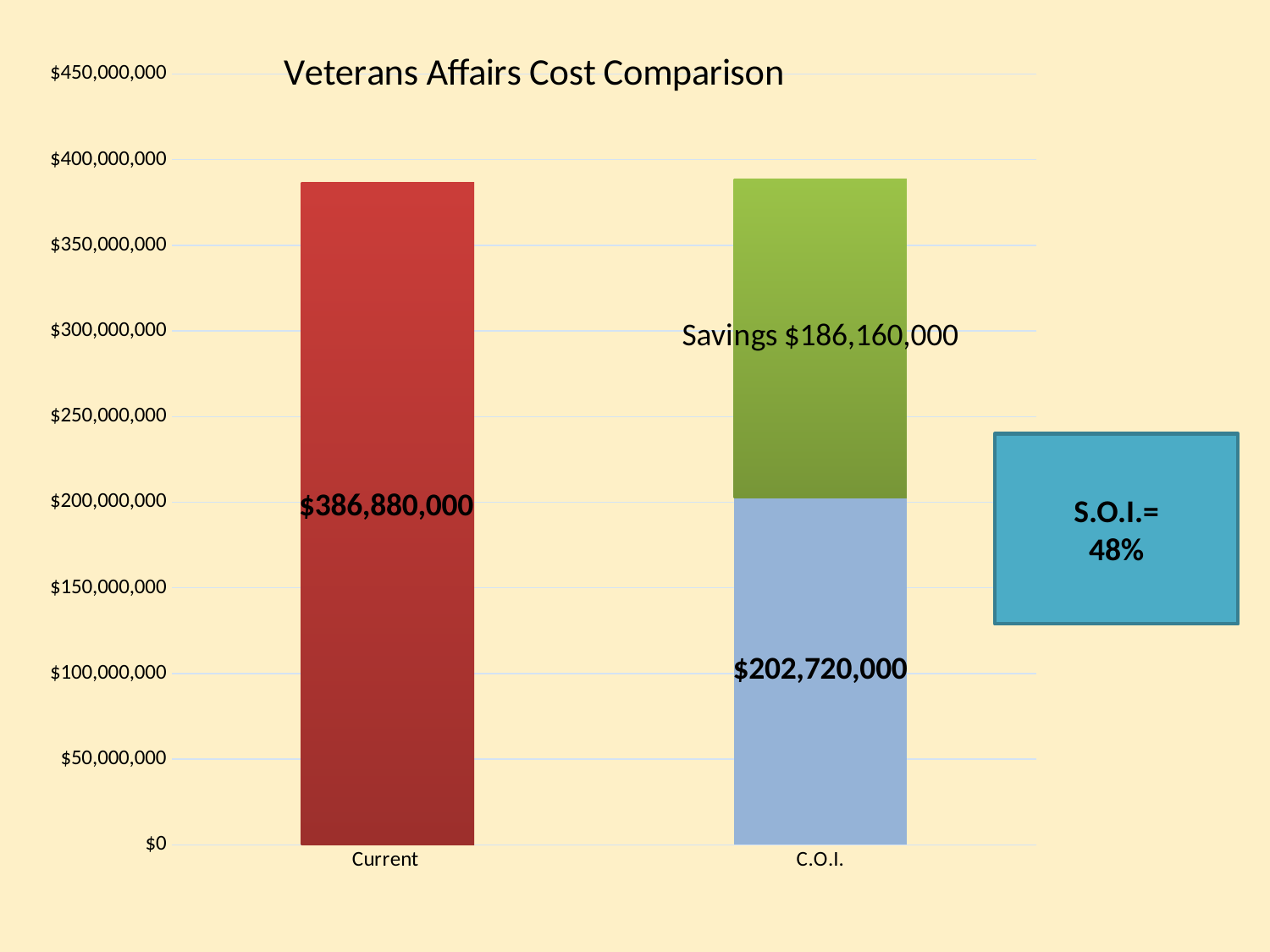
Is the value for Current greater or less than $350,000,000? greater What is the total of the C.O.I. stacked bar, adding the cost and savings segments? $388,880,000 How many categories are shown on the x axis? 2 Which is larger: the Current cost or the C.O.I. cost segment of $202,720,000? Current What is the cost value labelled on the blue segment of the C.O.I. bar? $202,720,000 What is the highest value shown on the y axis? $450,000,000 What S.O.I. percentage is shown in the box to the right of the chart? 48% What kind of chart is shown on the slide? Bar chart What is the value shown for the Current bar? $386,880,000 What is the title of the chart? Veterans Affairs Cost Comparison Is the cost segment of the C.O.I. bar greater or less than $250,000,000? less What savings amount is labelled on the green segment of the C.O.I. bar? $186,160,000